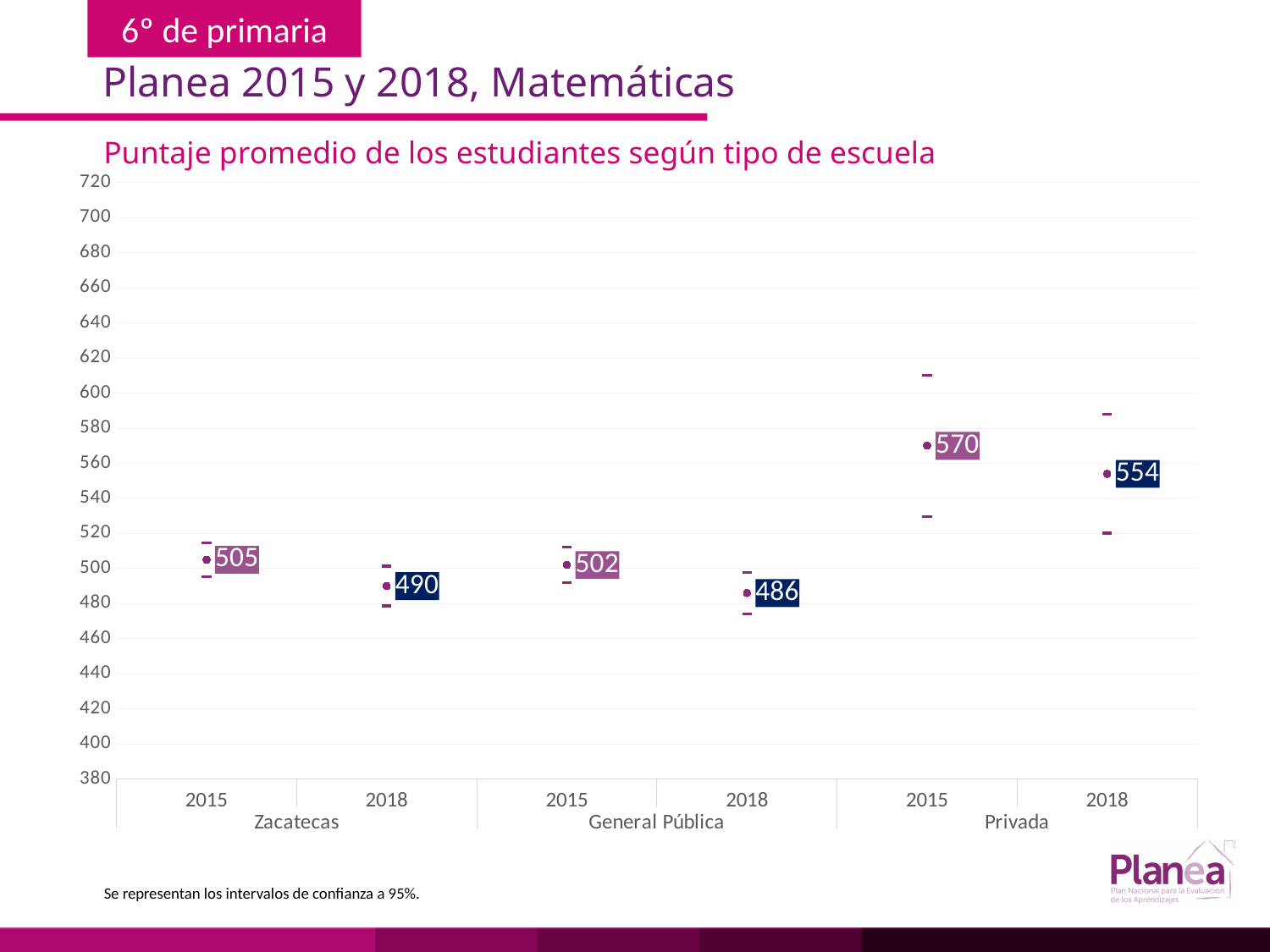
What is the average score for Privada in 2015? 570 Which is larger, the Zacatecas 2018 score or the General Pública 2018 score? Zacatecas 2018 What is the average score for Zacatecas in 2018? 490 What is the average score for Zacatecas in 2015? 505 Which school type and year has the highest average score? Privada 2015 What is the difference between the Zacatecas 2015 score and the Zacatecas 2018 score? 15 How many data points are plotted on the chart? 6 What is the average score for General Pública in 2018? 486 By how many points did the Privada average score change from 2015 to 2018? 16 Which school type and year has the lowest average score? General Pública 2018 What is the average score for Privada in 2018? 554 What is the average score for General Pública in 2015? 502